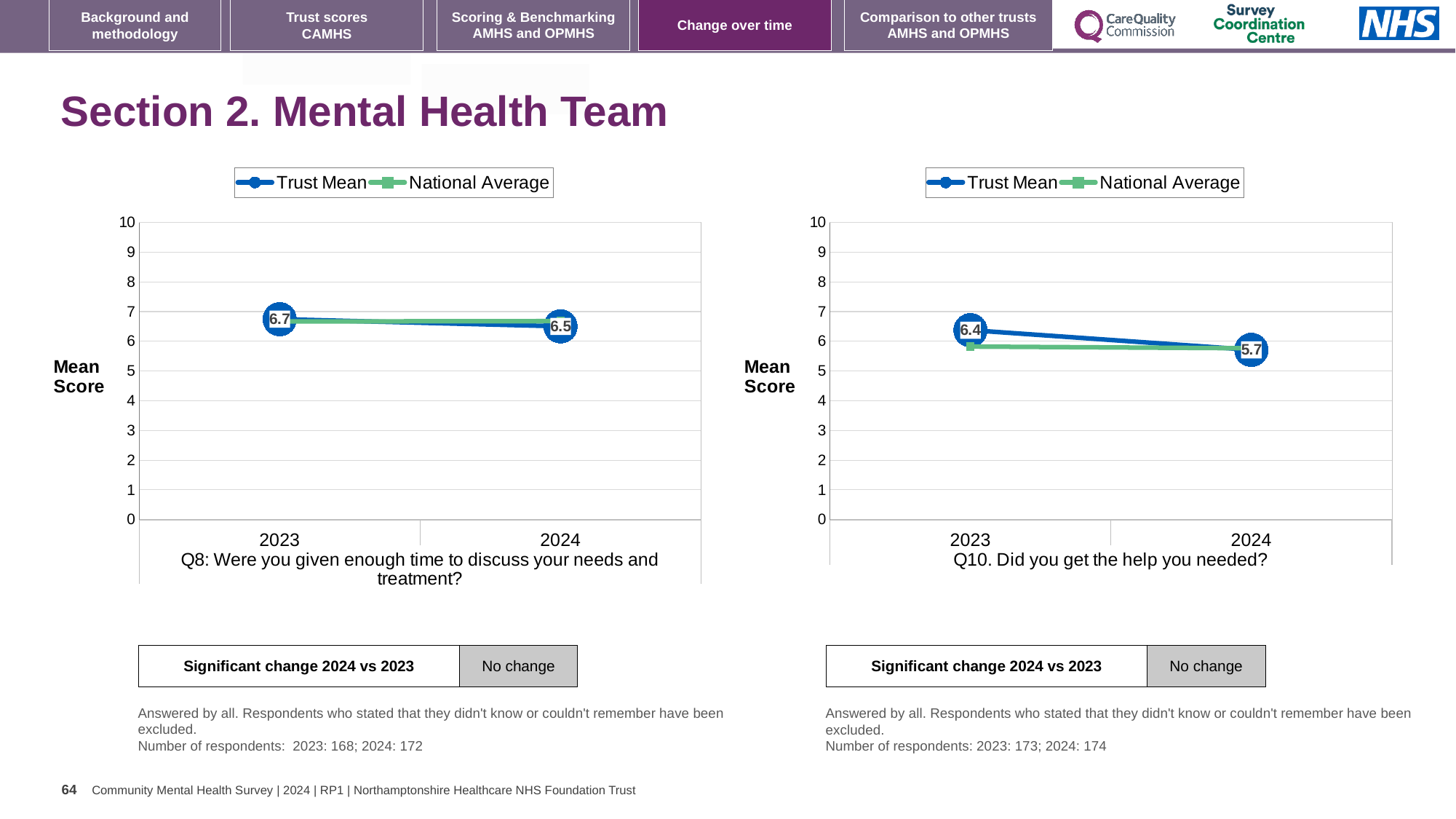
How many years are plotted on the x axis of the Q8 chart (left)? 2 In the Q8 chart (left), what is the difference between the Trust Mean in 2023 and 2024? 0.2 In the Q10 chart (right), which series has the higher value in 2023, Trust Mean or National Average? Trust Mean In the Q10 chart (right), does the Trust Mean rise or fall from 2023 to 2024? fall What type of chart is used for Q8 (left)? line chart How many series does the legend of the Q10 chart (right) list? 2 In the Q8 chart (left), what is the Trust Mean score for 2024? 6.5 In the Q10 chart (right), by how much did the Trust Mean fall from 2023 to 2024? 0.7 In the Q10 chart (right), what is the Trust Mean score for 2023? 6.4 In the Q8 chart (left), what is the Trust Mean score for 2023? 6.7 In the Q10 chart (right), what is the Trust Mean score for 2024? 5.7 In the Q10 chart (right), is the National Average for 2023 greater or less than 6? less